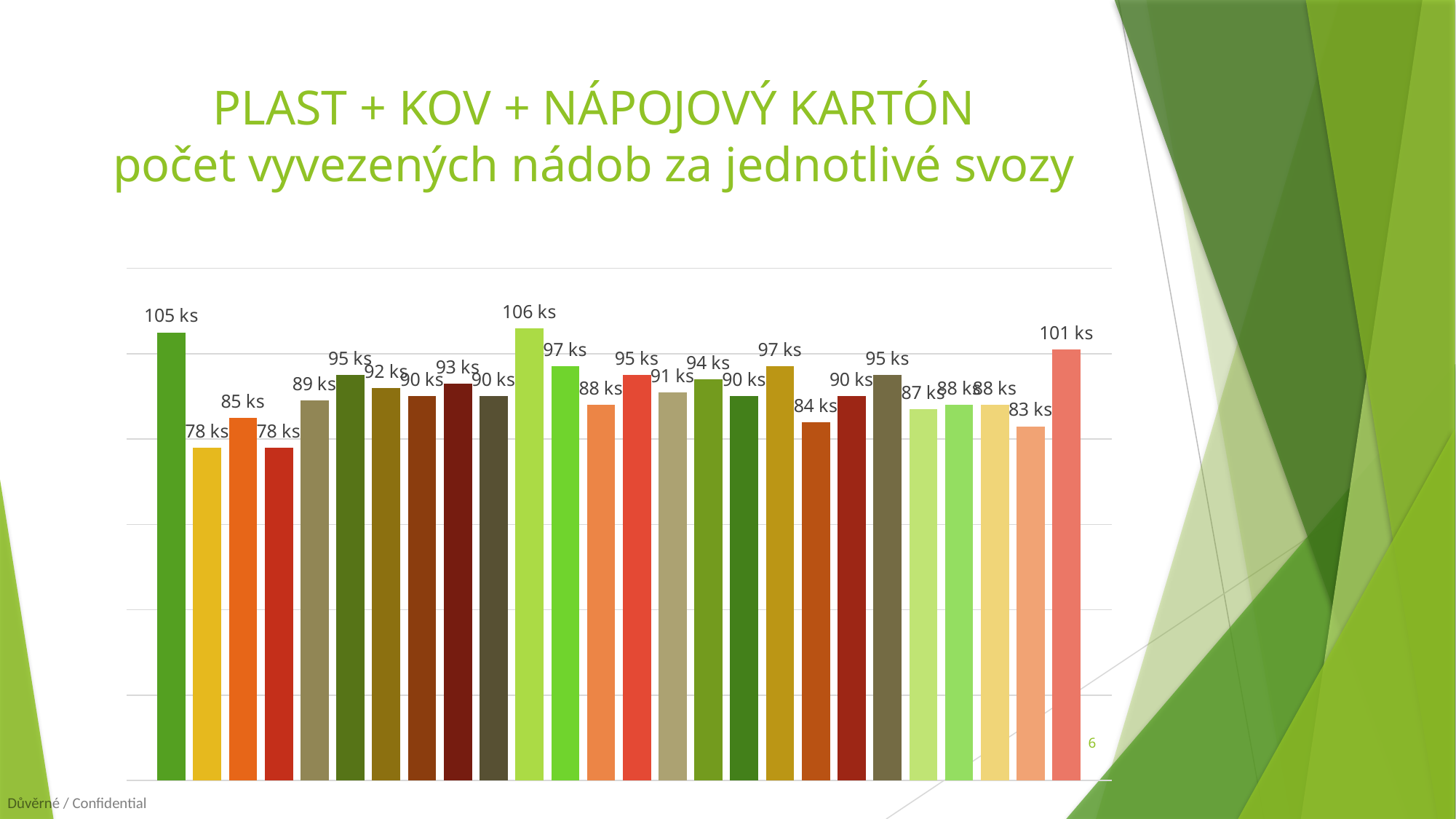
Which is larger, the first bar (105 ks) or the last bar (101 ks)? the first bar (105 ks) What is the highest value shown in the chart? 106 ks How many bars are plotted in the chart? 26 What is the value of the first (leftmost) bar in the chart? 105 ks What is the difference between the first bar (105 ks) and the last bar (101 ks)? 4 ks What is the value of the second bar from the left in the chart? 78 ks What kind of chart is shown on the slide? bar chart What is the lowest value shown in the chart? 78 ks What is the difference between the highest and the lowest value in the chart? 28 ks What is the title of the slide containing the chart? PLAST + KOV + NÁPOJOVÝ KARTÓN počet vyvezených nádob za jednotlivé svozy What unit is used in the data labels of the chart? ks What is the value of the last (rightmost) bar in the chart? 101 ks